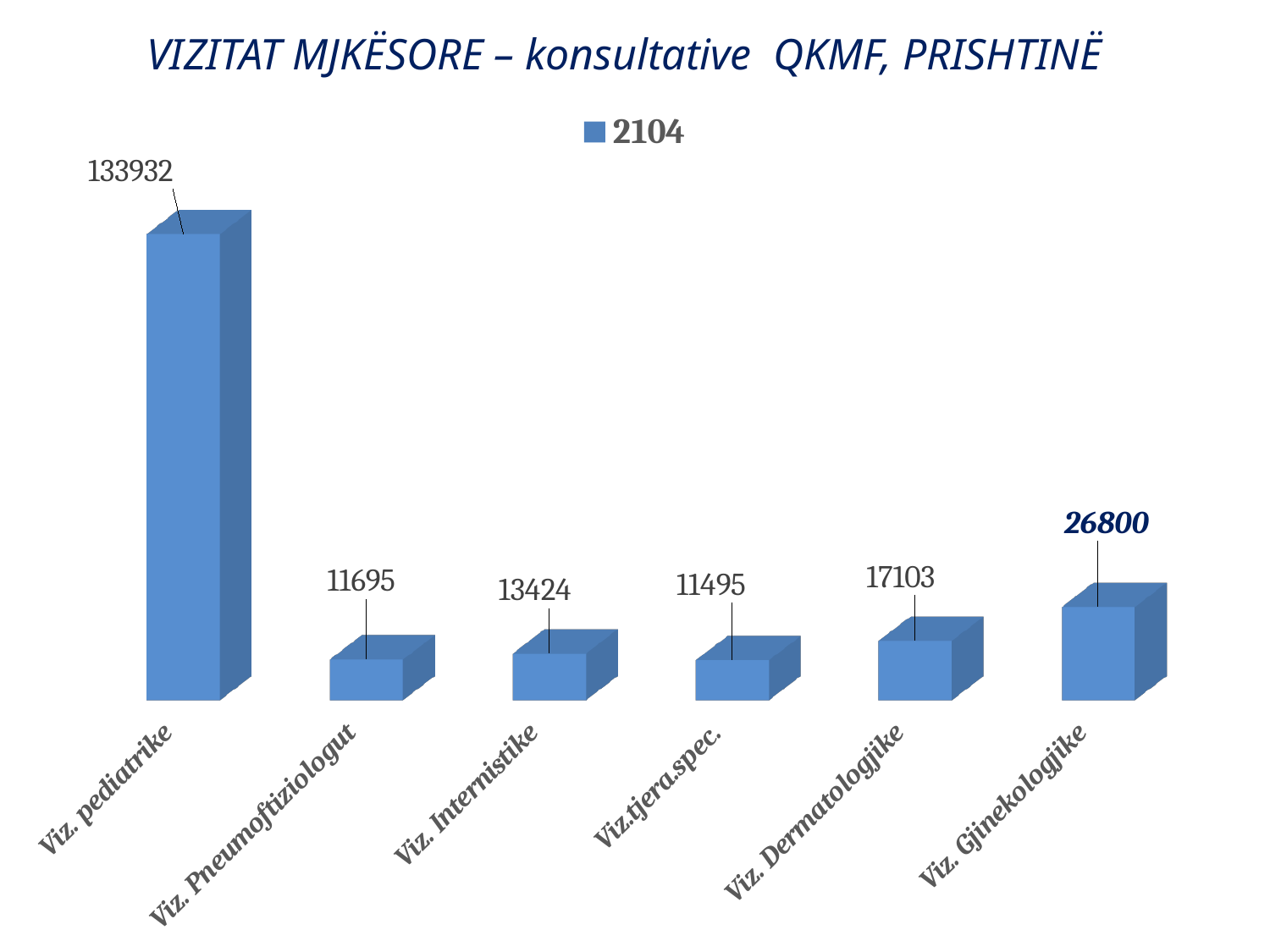
What is the legend entry shown for the series? 2104 Which category has the highest value? Viz. pediatrike What kind of chart is shown on the slide? Bar chart What is the value for Viz. Internistike? 13424 How many categories are shown in the chart? 6 What is the value for Viz. pediatrike? 133932 Which category has the lowest value? Viz.tjera.spec. Which is larger, the value for Viz. Internistike or the value for Viz. Dermatologjike? Viz. Dermatologjike What is the difference between the values for Viz. Gjinekologjike and Viz. Dermatologjike? 9697 What is the difference between the values for Viz. Pneumoftiziologut and Viz.tjera.spec.? 200 What is the value for Viz. Gjinekologjike? 26800 What is the value for Viz. Dermatologjike? 17103